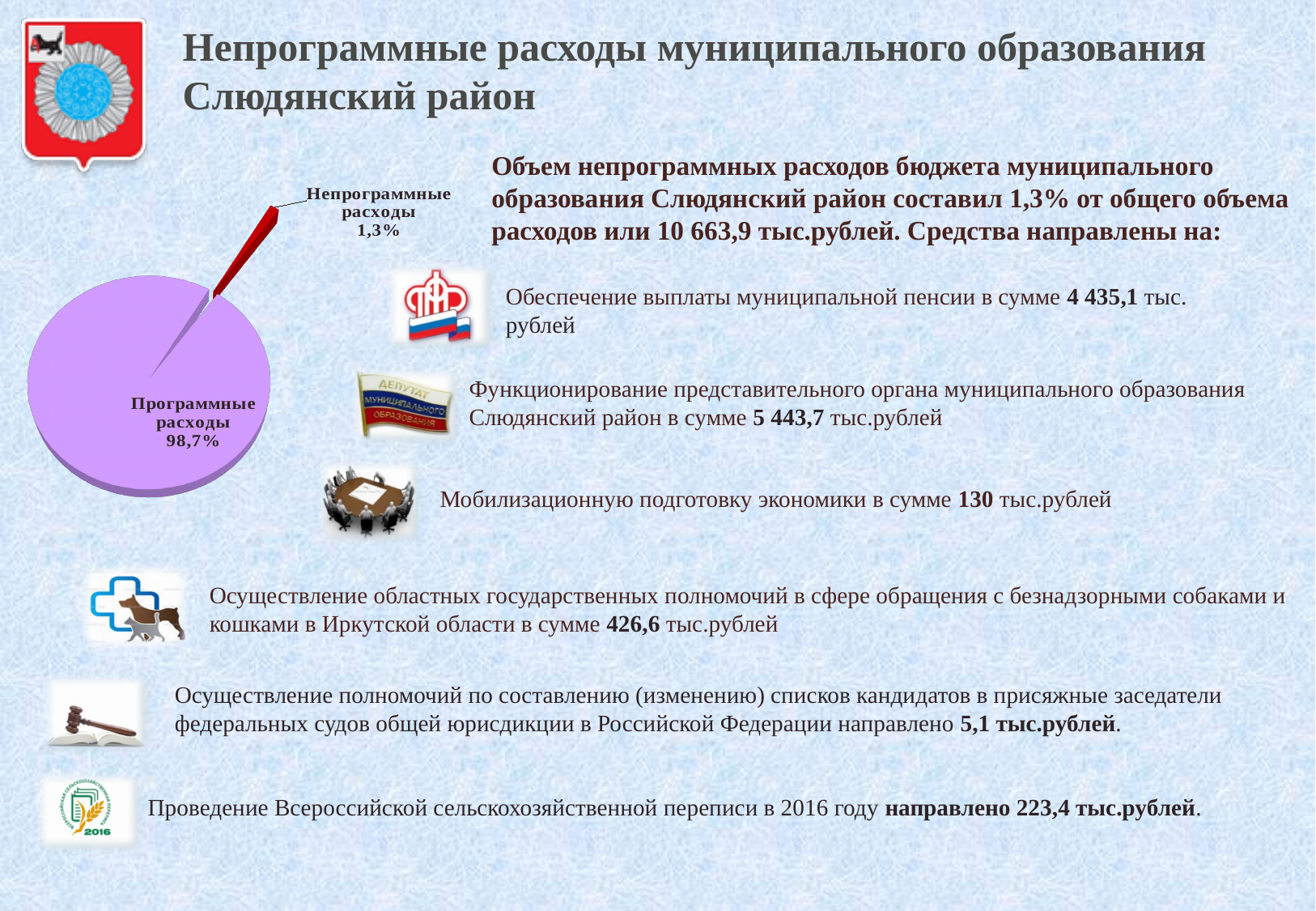
Which slice of the pie chart is the largest? Программные расходы What share of the pie does "Программные расходы" take? 98,7% What colour is the "Непрограммные расходы" slice in the pie chart? red Which is larger in the pie chart: "Программные расходы" or "Непрограммные расходы"? Программные расходы What is the difference in percentage points between the "Программные расходы" and "Непрограммные расходы" slices? 97,4 What kind of chart is shown on the slide? pie chart How many slices does the pie chart have? 2 Which slice of the pie chart is the smallest? Непрограммные расходы What share of the pie does "Непрограммные расходы" take? 1,3% What colour is the "Программные расходы" slice in the pie chart? purple